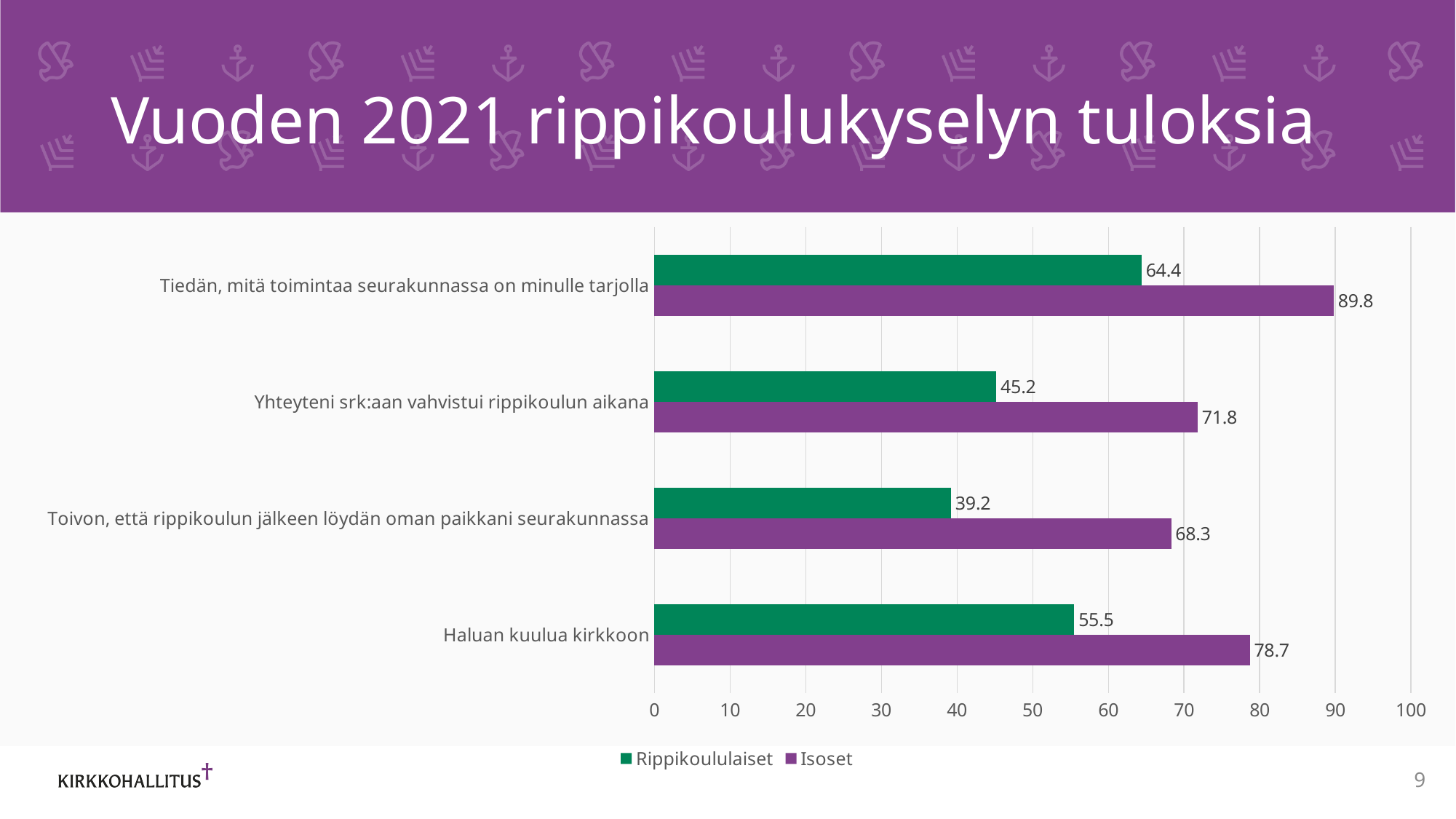
What is the value for Isoset for "Tiedän, mitä toimintaa seurakunnassa on minulle tarjolla"? 89.8 What is the value for Rippikoululaiset for "Yhteyteni srk:aan vahvistui rippikoulun aikana"? 45.2 What is the difference between the Isoset and Rippikoululaiset values for "Toivon, että rippikoulun jälkeen löydän oman paikkani seurakunnassa"? 29.1 Is the Isoset value for "Yhteyteni srk:aan vahvistui rippikoulun aikana" greater or less than 70? greater How many categories are shown on the chart? 4 How many series does the legend list? 2 Which category has the lowest value for Rippikoululaiset? Toivon, että rippikoulun jälkeen löydän oman paikkani seurakunnassa Which colour represents the Isoset series? Purple What is the value for Rippikoululaiset for "Haluan kuulua kirkkoon"? 55.5 Which category has the highest value for Isoset? Tiedän, mitä toimintaa seurakunnassa on minulle tarjolla What kind of chart is shown on the slide? Bar chart Which series has the larger value for "Haluan kuulua kirkkoon", Rippikoululaiset or Isoset? Isoset